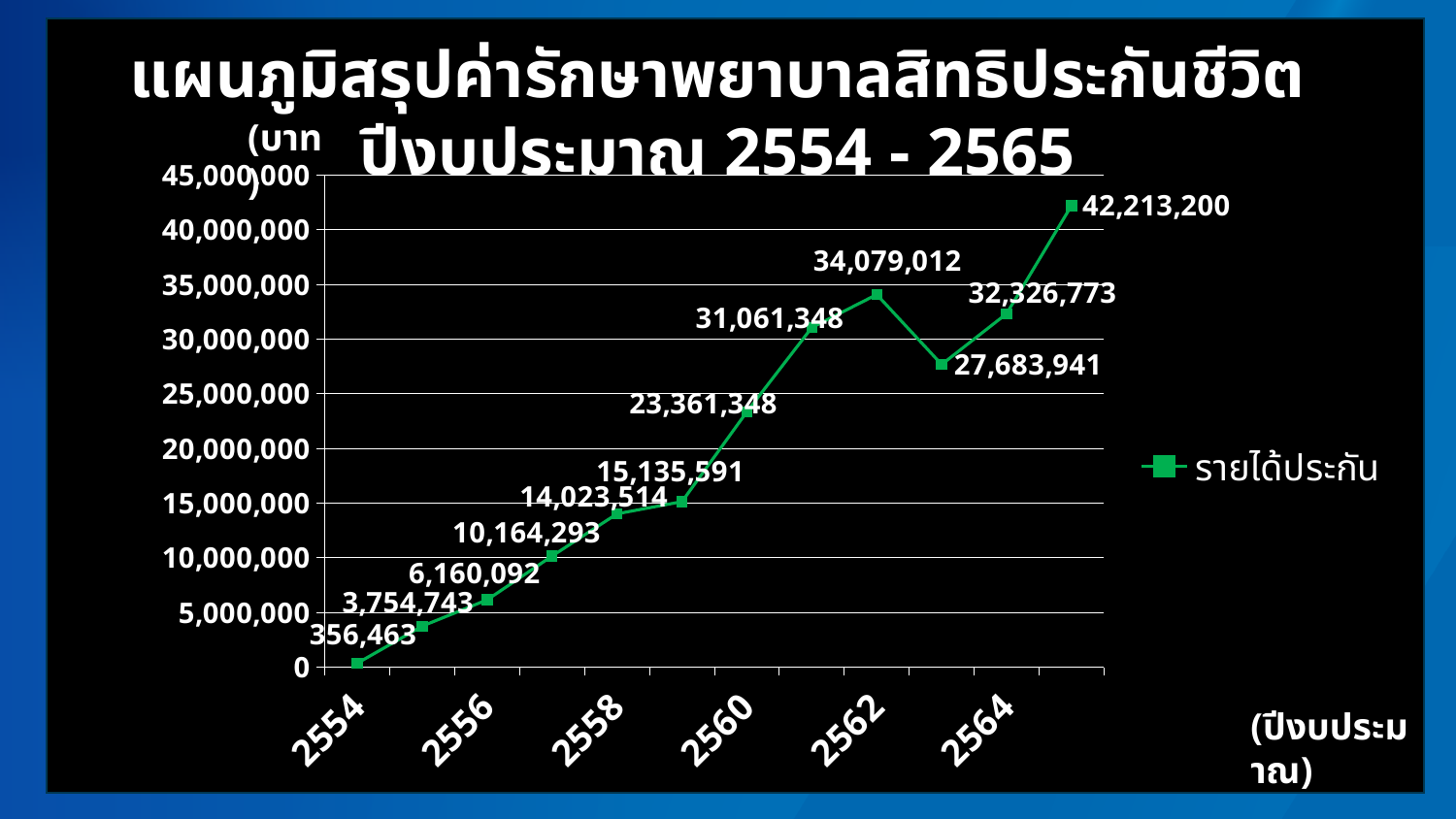
What is the value for 2564? 32,326,773 What is the value for 2558? 14,023,514 Which year has the highest value? 2565 Which is larger, the value for 2560 or the value for 2562? 2562 What is the value for 2556? 6,160,092 What is the difference between the values for 2562 and 2564? 1,752,239 Which year has the lowest value? 2554 What is the value for 2560? 23,361,348 How many series does the legend list? 1 What is the value for 2554? 356,463 What is the value for 2562? 34,079,012 What type of chart is shown on the slide? line chart